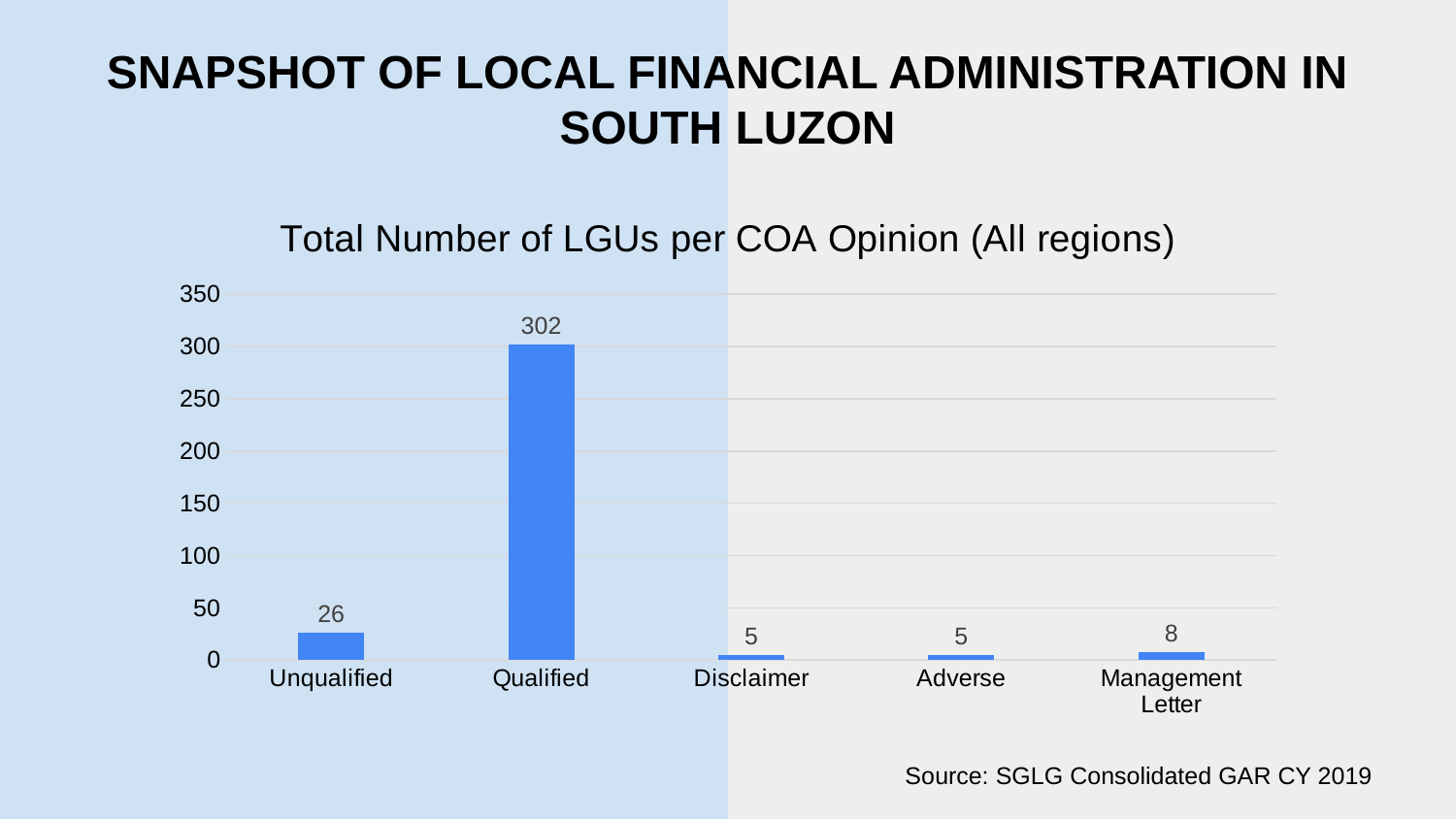
Which category has the highest value? Qualified What is the difference between the values for Qualified and Unqualified? 276 How many categories are shown on the x axis? 5 What is the value for Qualified? 302 Which is larger, the value for Unqualified or the value for Management Letter? Unqualified Is the value for Qualified greater or less than 300? greater What is the difference between the values for Management Letter and Adverse? 3 What is the value for Disclaimer? 5 What is the value for Unqualified? 26 What is the value for Management Letter? 8 What kind of chart is shown on the slide? Bar chart What is the title of the chart? Total Number of LGUs per COA Opinion (All regions)